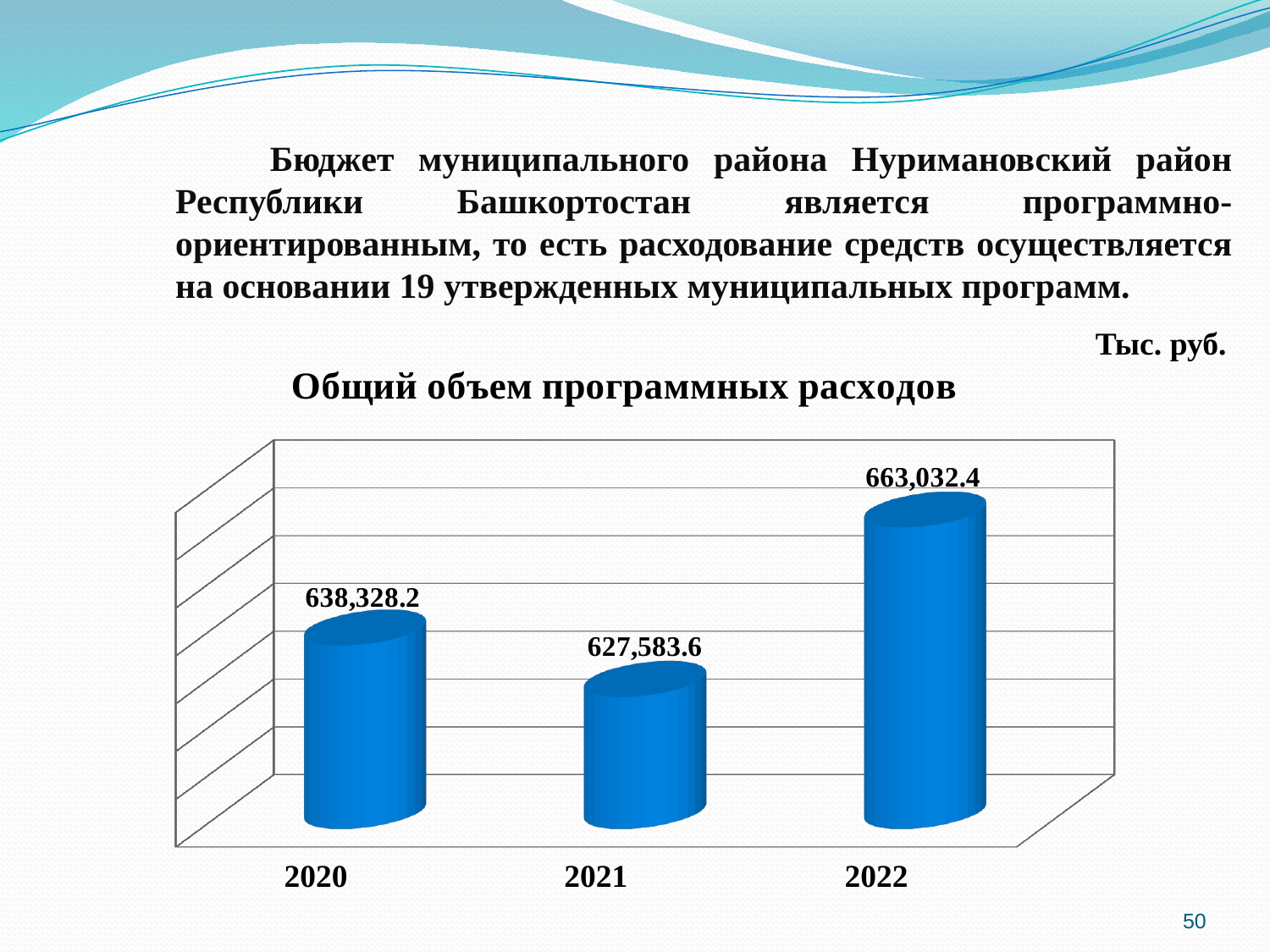
What is the value for 2022 in the chart "Общий объем программных расходов"? 663,032.4 How many years are shown on the x axis of the chart? 3 Which year has the lowest value in the chart? 2021 What is the difference between the values for 2020 and 2021? 10,744.6 What is the difference between the values for 2022 and 2020? 24,704.2 What is the value for 2021 in the chart "Общий объем программных расходов"? 627,583.6 Which is larger, the value for 2020 or the value for 2021? 2020 Which year has the highest value in the chart? 2022 Does the value rise or fall from 2021 to 2022? rise What kind of chart is shown on the slide? bar chart What is the difference between the values for 2022 and 2021? 35,448.8 What is the value for 2020 in the chart "Общий объем программных расходов"? 638,328.2